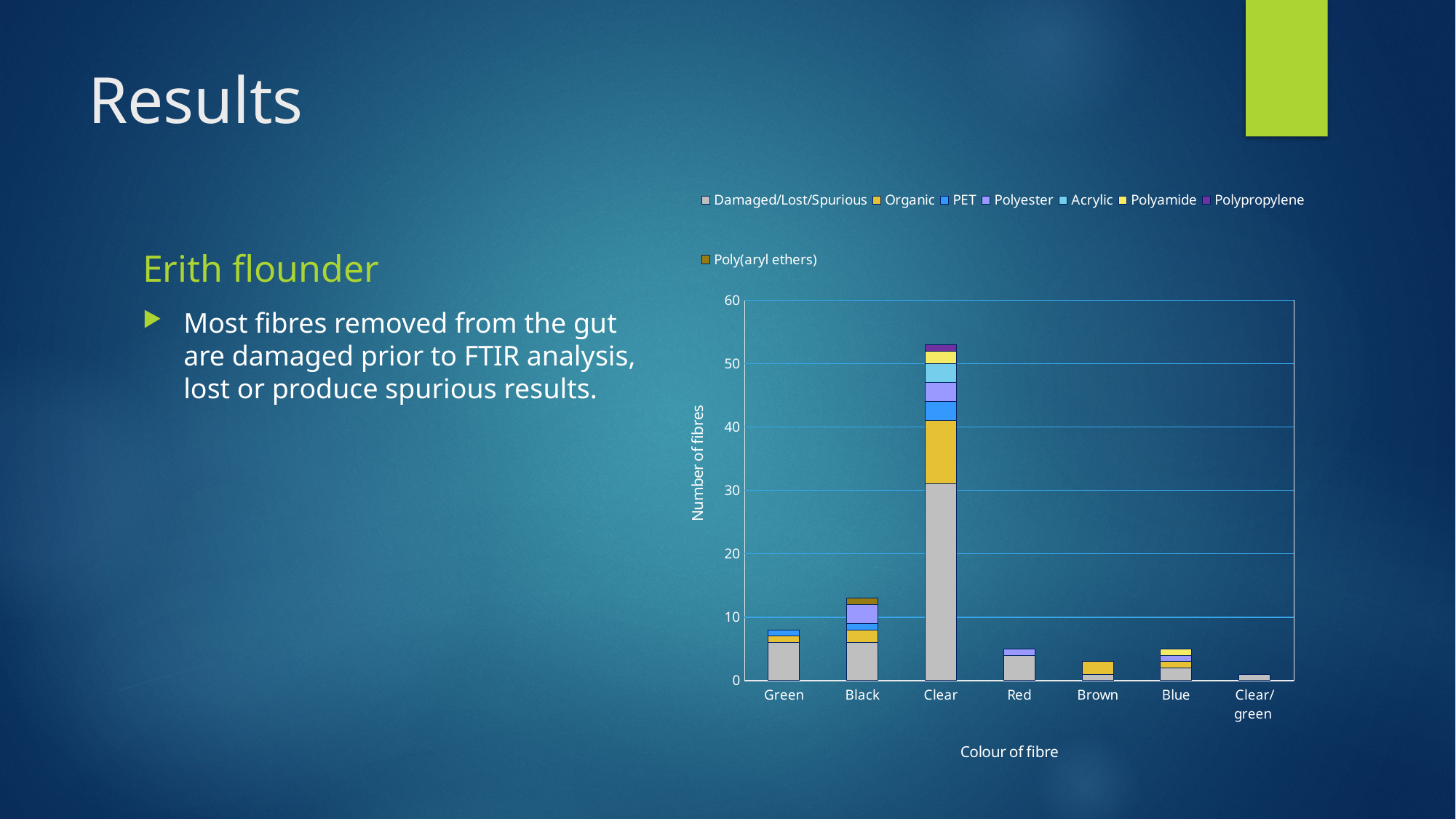
What kind of chart is shown on the slide? stacked bar chart Which has a taller stacked bar, Black or Green? Black Is the Damaged/Lost/Spurious segment for Clear greater or less than 20? greater Which fibre colour has the shortest stacked bar? Clear/green Which fibre colour has the tallest stacked bar? Clear How many series does the legend list? 8 Is the total number of fibres for Clear greater or less than 50? greater What is the label of the y axis? Number of fibres Is the total number of fibres for Black greater or less than 10? greater How many fibre colour categories are shown on the x axis? 7 Which has a taller stacked bar, Brown or Clear/green? Brown